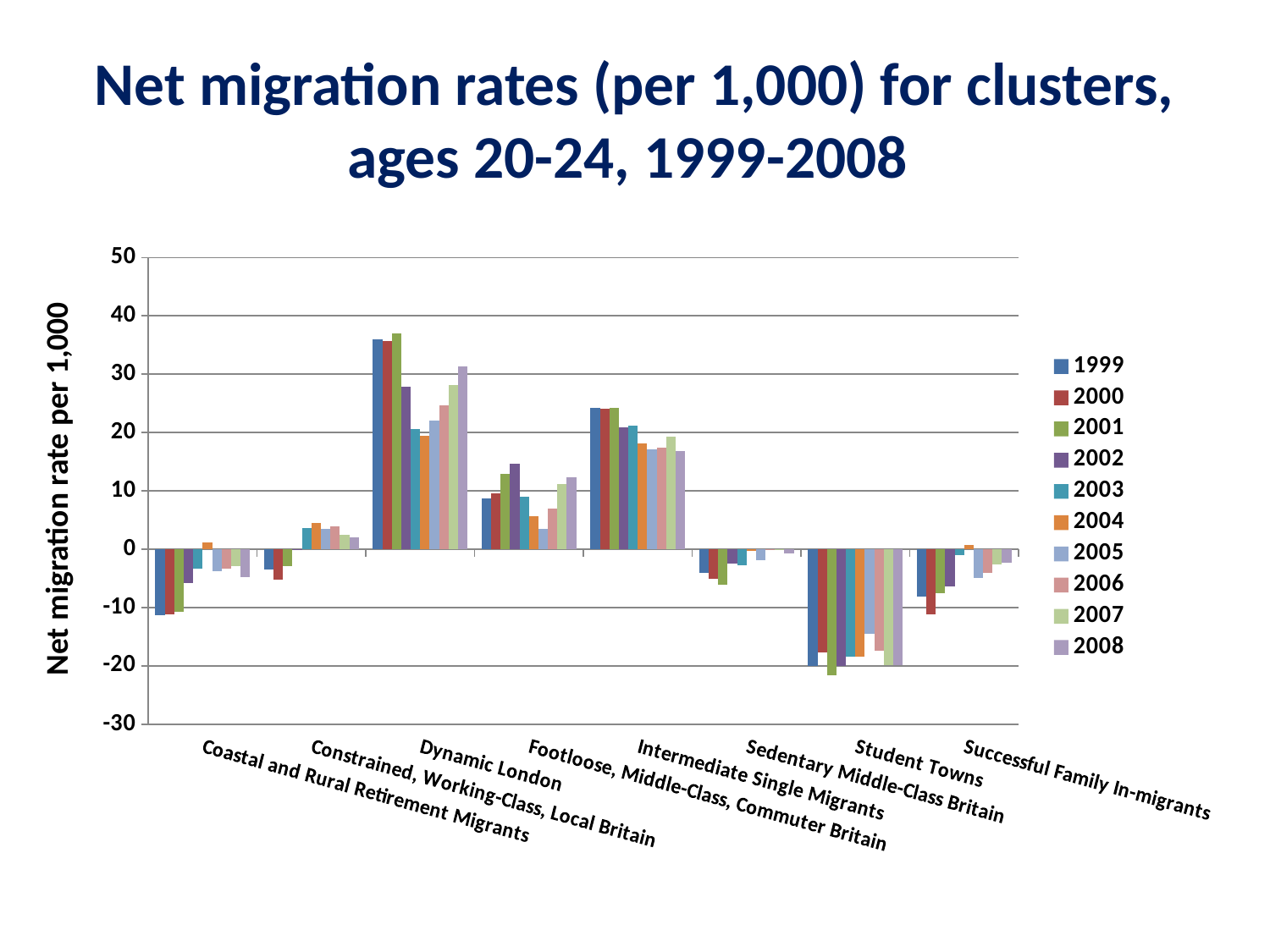
For Dynamic London, which year has the larger value: 2001 or 2002? 2001 What is the title of the vertical axis? Net migration rate per 1,000 Is the 1999 value for Student Towns greater or less than -10? less For Intermediate Single Migrants, which year has the larger value: 1999 or 2008? 1999 Is the 1999 value for Intermediate Single Migrants greater or less than 20? greater Which cluster has the highest net migration rate in 2001? Dynamic London Is the 2002 value for Footloose, Middle-Class, Commuter Britain greater or less than 10? greater Which cluster has the lowest net migration rate in 2001? Student Towns What kind of chart is shown on the slide? bar chart How many clusters (categories) are shown along the x axis? 8 How many series (years) does the legend list? 10